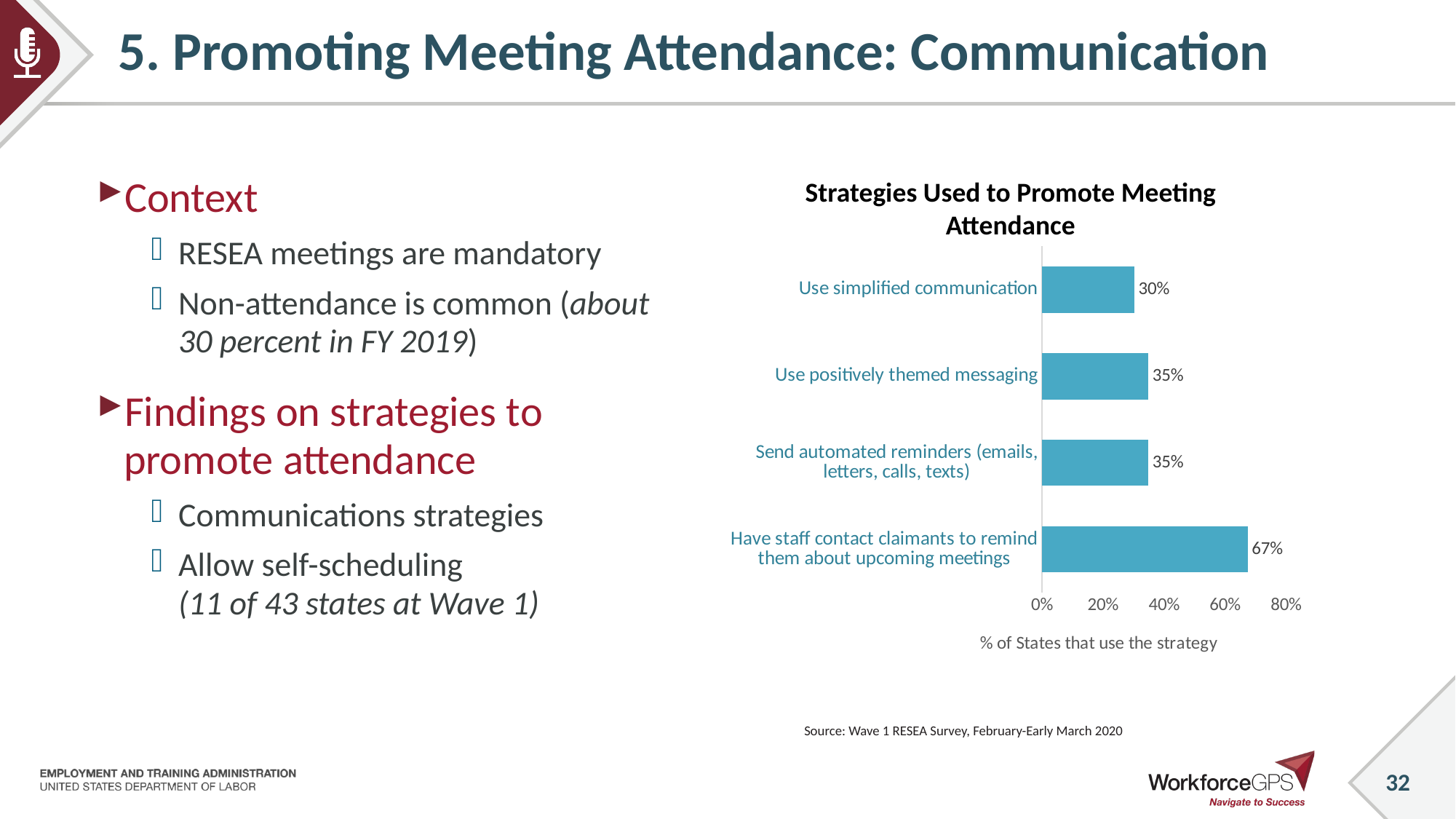
Which is larger: the share of states using positively themed messaging or the share using simplified communication? Use positively themed messaging Which strategy is used by the highest percentage of states? Have staff contact claimants to remind them about upcoming meetings What is the label on the horizontal axis of the chart? % of States that use the strategy What type of chart is used to show the strategies used to promote meeting attendance? Bar chart What is the difference in percentage points between having staff contact claimants and using simplified communication? 37 percentage points Which strategy is used by the lowest percentage of states? Use simplified communication What percentage of states have staff contact claimants to remind them about upcoming meetings? 67% What percentage of states use positively themed messaging? 35% Is the value for sending automated reminders greater or less than 40%? less How many strategies are shown in the chart? 4 What is the title of the chart? Strategies Used to Promote Meeting Attendance What percentage of states use simplified communication to promote meeting attendance? 30%